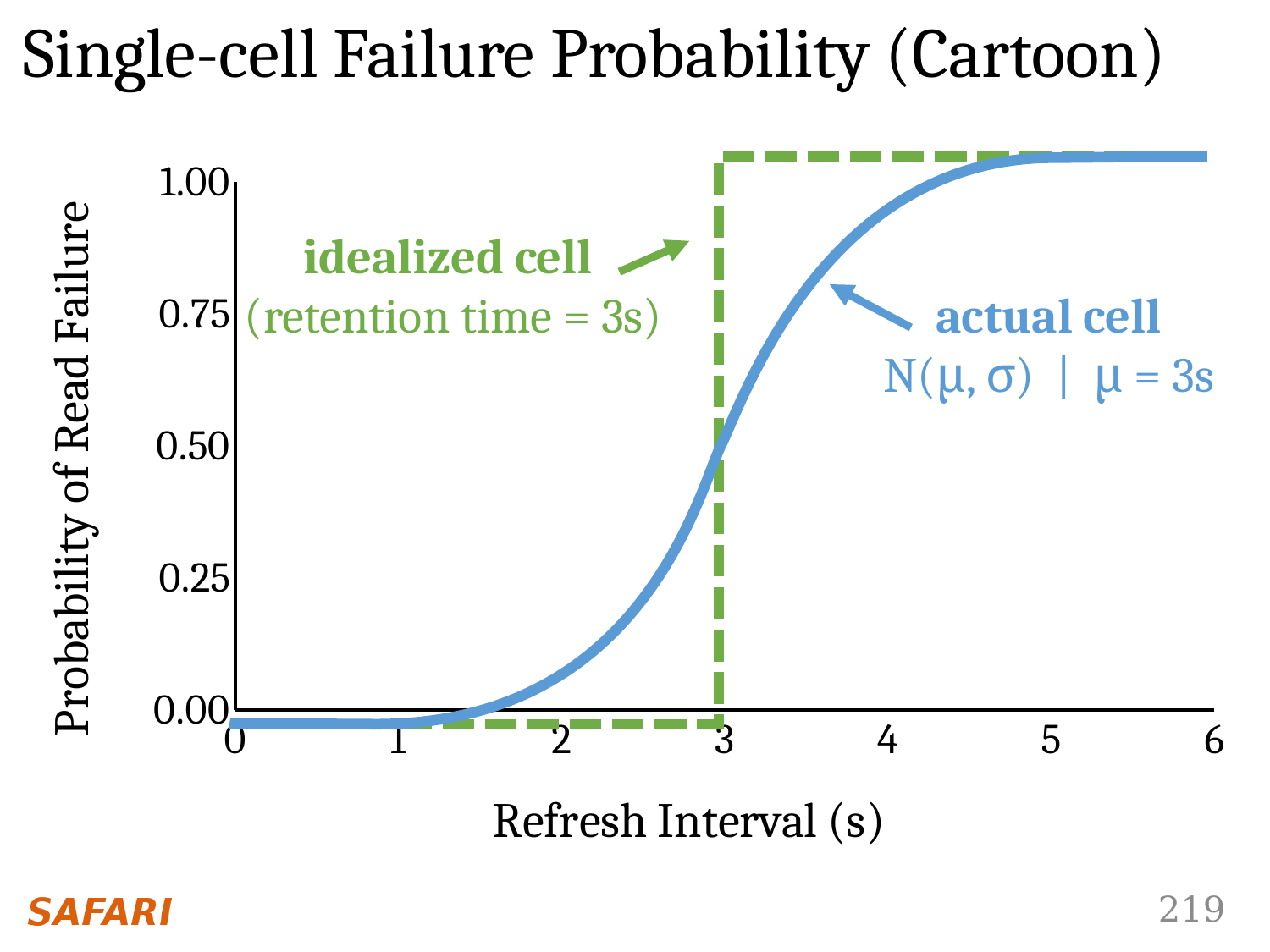
What is the label of the x axis? Refresh Interval (s) Does the probability of read failure for the actual cell rise or fall as the refresh interval increases? rise Is the probability of read failure for the actual cell at a refresh interval of 4 s greater or less than 0.75? greater How many curves are plotted on the chart? 2 At a refresh interval of 4 s, which curve shows the higher probability of read failure, the idealized cell or the actual cell? idealized cell What retention time is given for the idealized cell? 3s What value of μ is given for the actual cell? 3s What kind of chart is shown on the slide? line chart Is the probability of read failure for the actual cell at a refresh interval of 2 s greater or less than 0.25? less Is the probability of read failure for the idealized cell at a refresh interval of 2 s greater or less than 0.25? less What is the title of the chart on the slide? Single-cell Failure Probability (Cartoon) At a refresh interval of 2 s, which curve shows the higher probability of read failure, the idealized cell or the actual cell? actual cell